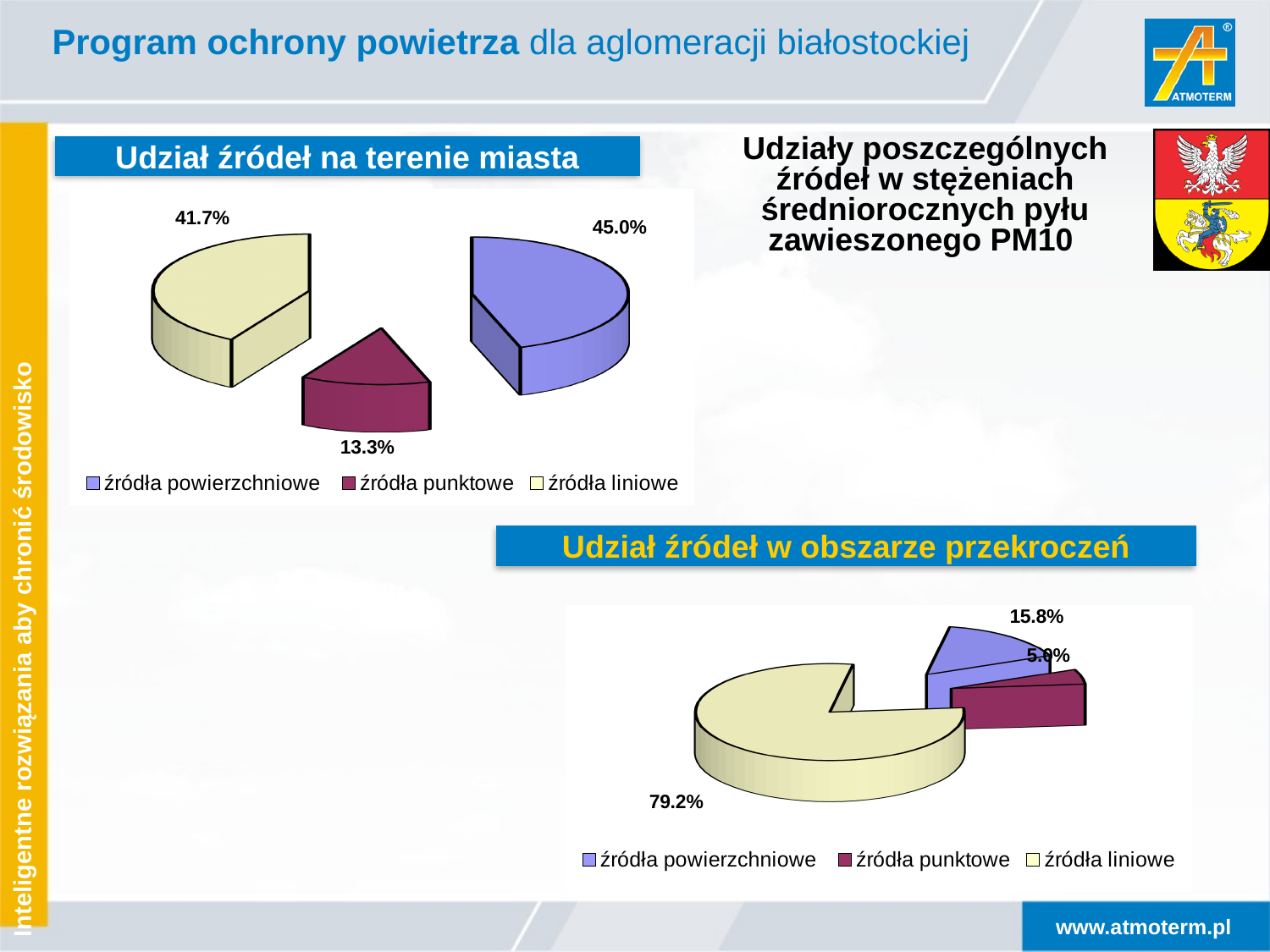
In the chart titled 'Udział źródeł na terenie miasta', which source category has the largest share? źródła powierzchniowe In the chart titled 'Udział źródeł na terenie miasta', what share do źródła punktowe have? 13.3% In the chart titled 'Udział źródeł w obszarze przekroczeń', which source category has the largest share? źródła liniowe In the chart titled 'Udział źródeł na terenie miasta', which source category has the smallest share? źródła punktowe In the chart titled 'Udział źródeł na terenie miasta', what share do źródła powierzchniowe have? 45.0% In the chart titled 'Udział źródeł w obszarze przekroczeń', what share do źródła powierzchniowe have? 15.8% In the chart titled 'Udział źródeł w obszarze przekroczeń', what share do źródła liniowe have? 79.2% In the chart titled 'Udział źródeł w obszarze przekroczeń', which source category has the smallest share? źródła punktowe In the chart titled 'Udział źródeł na terenie miasta', what share do źródła liniowe have? 41.7% What type of chart is 'Udział źródeł w obszarze przekroczeń'? pie chart How many entries does the legend of the chart titled 'Udział źródeł na terenie miasta' list? 3 In the chart titled 'Udział źródeł na terenie miasta', what is the difference between the shares of źródła powierzchniowe and źródła liniowe? 3.3%